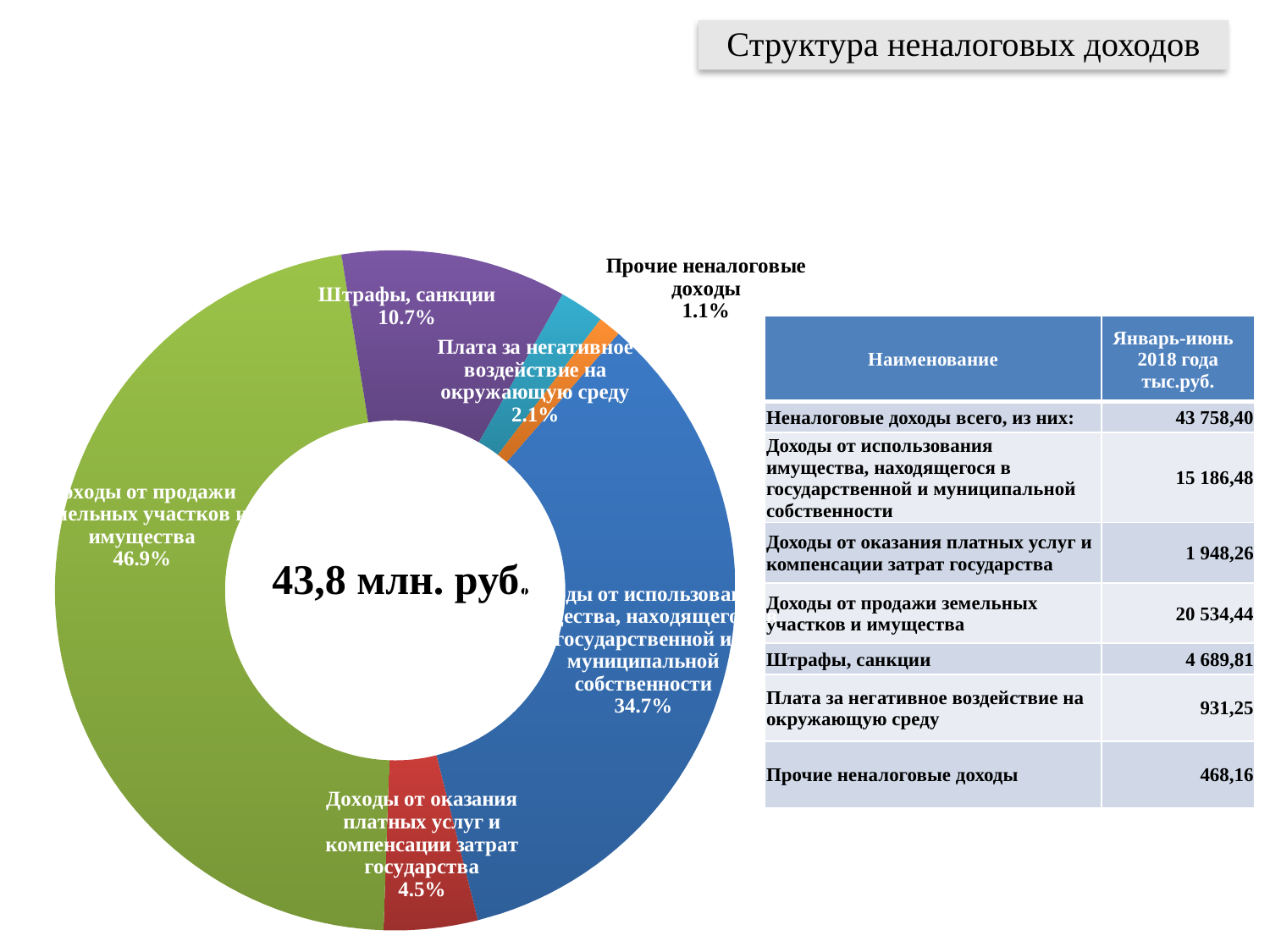
What total value is printed in the centre of the doughnut chart? 43,8 млн. руб. What percentage is shown for "Доходы от оказания платных услуг и компенсации затрат государства" in the chart? 4.5% What is the difference in percentage points between the slice for "Доходы от продажи земельных участков и имущества" (46.9%) and the slice for "Доходы от использования имущества, находящегося в государственной и муниципальной собственности" (34.7%)? 12.2 What percentage is shown for "Прочие неналоговые доходы" in the chart? 1.1% What is the title of the slide containing the chart? Структура неналоговых доходов How many categories are shown in the doughnut chart? 6 What share of the doughnut chart does "Штрафы, санкции" represent? 10.7% What kind of chart is shown on the slide? Doughnut (pie) chart Which slice is larger: "Штрафы, санкции" or "Доходы от оказания платных услуг и компенсации затрат государства"? Штрафы, санкции Which category has the smallest slice in the chart? Прочие неналоговые доходы Which category has the largest slice in the chart? Доходы от продажи земельных участков и имущества What percentage is shown for "Плата за негативное воздействие на окружающую среду" in the chart? 2.1%